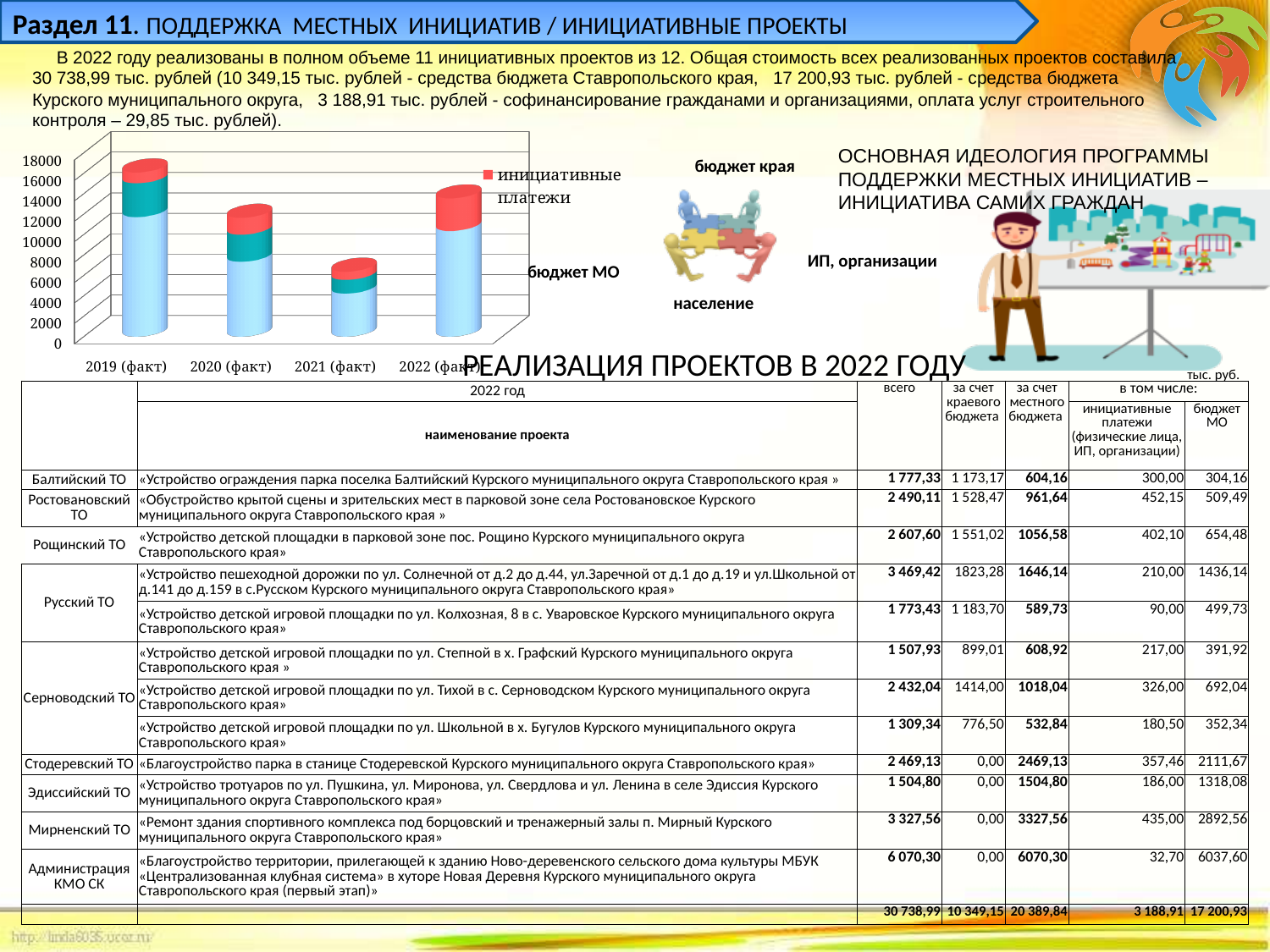
Is the total bar for 2022 (факт) greater or less than 12000? greater Which total bar is larger, 2020 (факт) or 2021 (факт)? 2020 (факт) What kind of chart is shown on the left of the slide? bar chart Which total bar is larger, 2022 (факт) or 2021 (факт)? 2022 (факт) Is the total bar for 2020 (факт) greater or less than 10000? greater Do the total bar values rise or fall from 2019 (факт) to 2021 (факт)? fall Is the total bar for 2019 (факт) greater or less than 14000? greater Which year has the lowest total bar in the chart? 2021 (факт) Which series name is readable in the chart legend? инициативные платежи How many categories (years) are shown on the x axis of the bar chart? 4 What colour represents the series 'инициативные платежи' in the chart? red